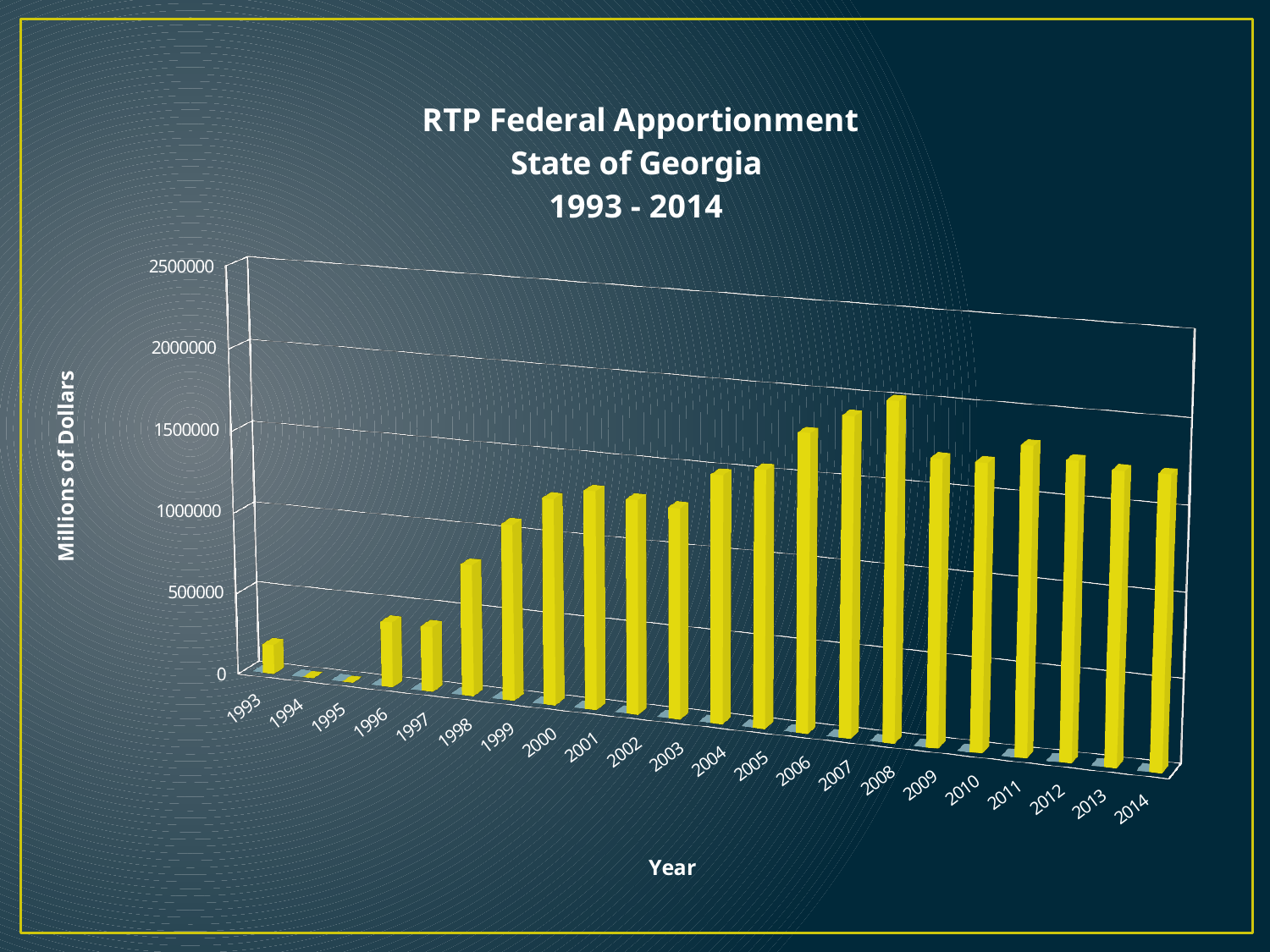
Is the value for 1993 greater or less than 500000? less Is the value for 2008 greater or less than 1500000? greater What type of chart is shown on the slide? Bar chart How many years are plotted on the x axis of the chart? 22 Which year has the larger value, 2005 or 2006? 2006 Which year has the larger value, 1997 or 1998? 1998 Is the value for 2004 greater or less than 1000000? greater What is the label on the vertical axis of the chart? Millions of Dollars Do the values generally rise or fall from 1993 to 2008? rise Which year has the highest RTP Federal Apportionment in the chart? 2008